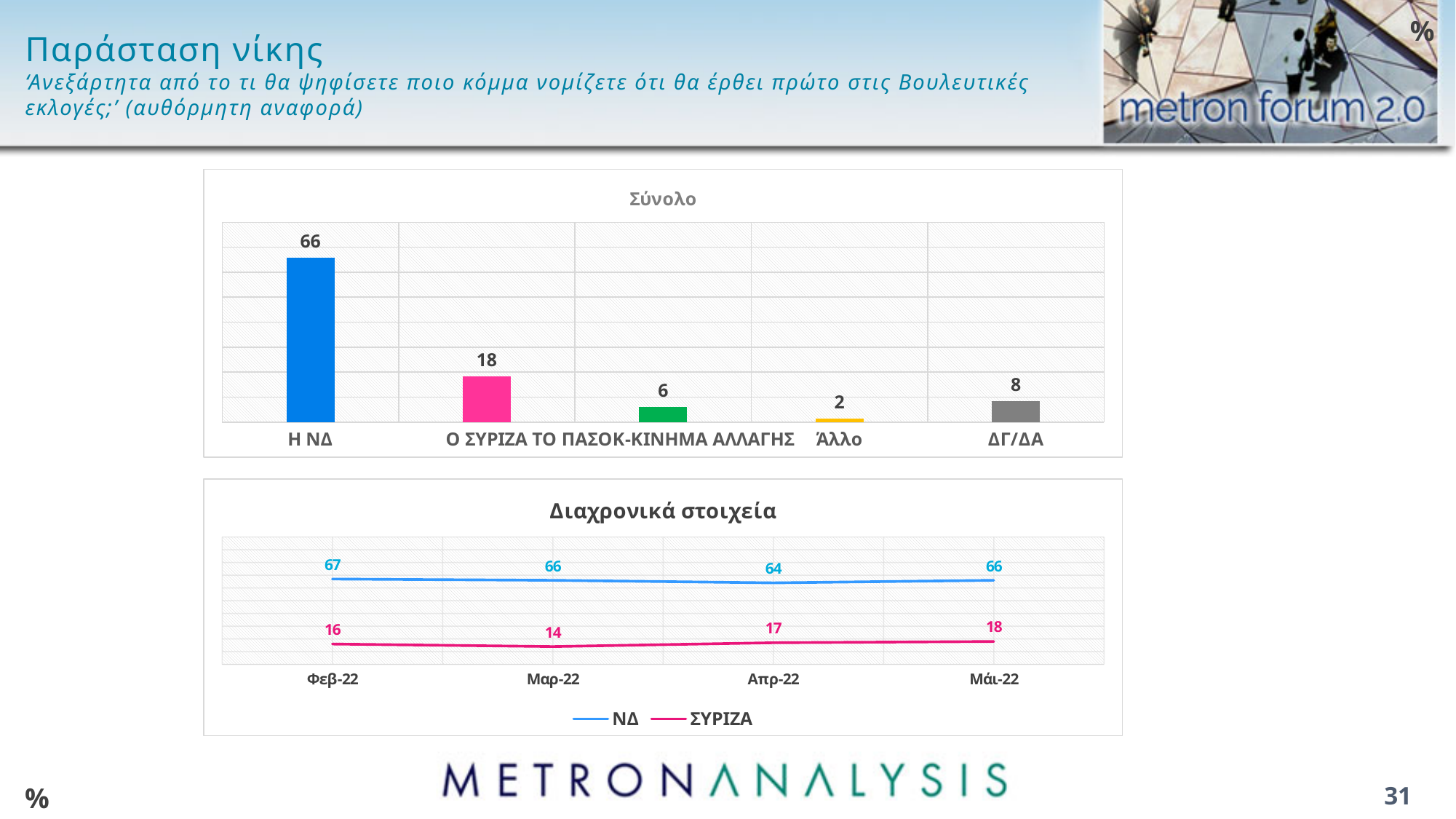
In the 'Σύνολο' bar chart, what is the value for Η ΝΔ? 66 In the 'Διαχρονικά στοιχεία' chart, what is the difference between ΝΔ and ΣΥΡΙΖΑ in Φεβ-22? 51 What kind of chart is the 'Διαχρονικά στοιχεία' chart? line chart How many categories are shown in the 'Σύνολο' bar chart? 5 In the 'Διαχρονικά στοιχεία' chart, how many series does the legend list? 2 In the 'Σύνολο' bar chart, what is the difference between the values for Η ΝΔ and Ο ΣΥΡΙΖΑ? 48 In the 'Διαχρονικά στοιχεία' chart, what is the value for ΝΔ in Απρ-22? 64 In the 'Σύνολο' bar chart, which is larger: the value for ΔΓ/ΔΑ or the value for ΤΟ ΠΑΣΟΚ-ΚΙΝΗΜΑ ΑΛΛΑΓΗΣ? ΔΓ/ΔΑ In the 'Σύνολο' bar chart, what is the value for ΤΟ ΠΑΣΟΚ-ΚΙΝΗΜΑ ΑΛΛΑΓΗΣ? 6 In the 'Διαχρονικά στοιχεία' chart, what is the value for ΣΥΡΙΖΑ in Μαρ-22? 14 In the 'Διαχρονικά στοιχεία' chart, does the ΣΥΡΙΖΑ line rise or fall from Μαρ-22 to Μάι-22? rise In the 'Σύνολο' bar chart, which category has the lowest value? Άλλο